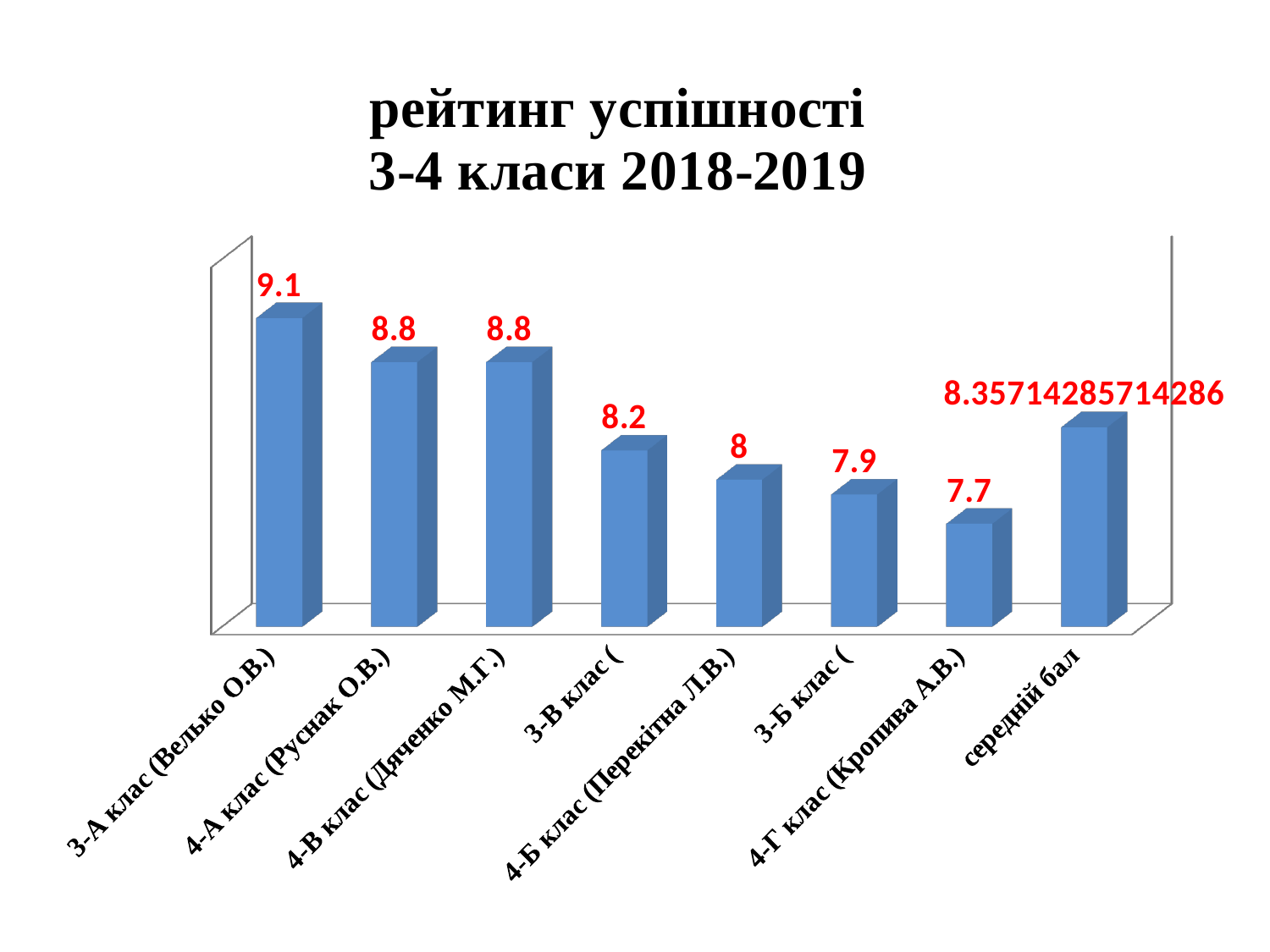
Which is larger, the value for 4-Б клас (Перекітна Л.В.) or 3-Б клас? 4-Б клас (Перекітна Л.В.) Which category has the lowest value? 4-Г клас (Кропива А.В.) What is the difference between the values for 4-А клас (Руснак О.В.) and 3-В клас? 0.6 What is the value for 3-А клас (Велько О.В.)? 9.1 What is the title of the chart? рейтинг успішності 3-4 класи 2018-2019 How many bars are plotted in the chart? 8 What is the difference between the values for 3-А клас (Велько О.В.) and 4-Г клас (Кропива А.В.)? 1.4 What is the value for 4-Б клас (Перекітна Л.В.)? 8 What kind of chart is shown on the slide? Bar chart What is the value for 4-Г клас (Кропива А.В.)? 7.7 Which category has the highest value? 3-А клас (Велько О.В.) What is the value shown for середній бал? 8.35714285714286